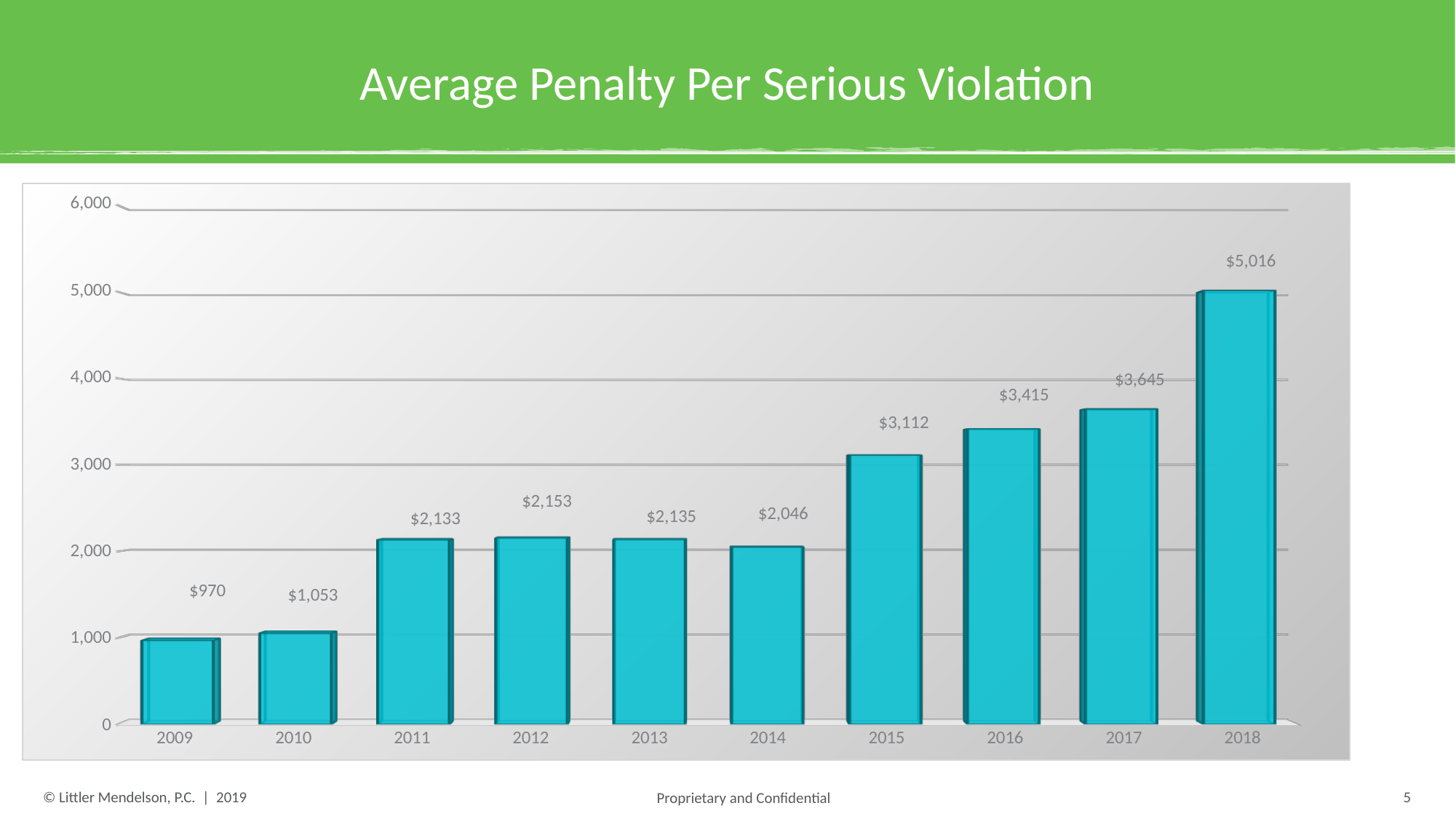
Which year has the highest average penalty per serious violation? 2018 How many years are shown on the chart? 10 What is the difference between the average penalty in 2018 and in 2017? $1,371 Is the value for 2017 greater or less than 4,000? less What is the average penalty per serious violation in 2018? $5,016 What is the title of the slide? Average Penalty Per Serious Violation What is the average penalty per serious violation in 2014? $2,046 Which year has the lowest average penalty per serious violation? 2009 What is the difference between the average penalty in 2010 and in 2009? $83 What kind of chart is shown on the slide? Bar chart What is the average penalty per serious violation in 2009? $970 Which year has a larger average penalty, 2015 or 2016? 2016